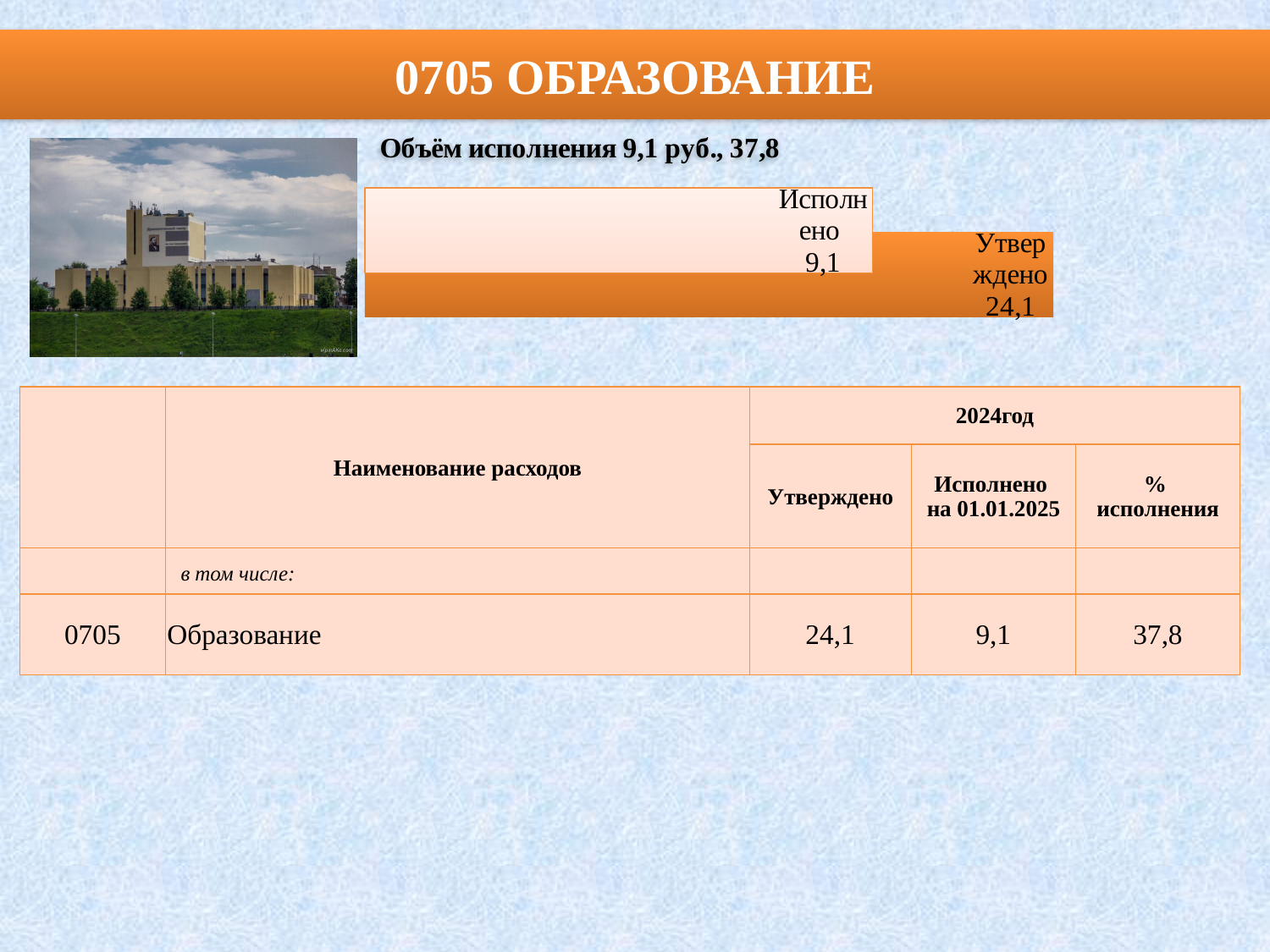
What is the difference between the "Утверждено" value and the "Исполнено" value? 15,0 What is the value of the bar labelled "Утверждено"? 24,1 What is the title shown in the orange banner at the top of the slide? 0705 ОБРАЗОВАНИЕ What is the value of the bar labelled "Исполнено"? 9,1 What colour is the bar labelled "Утверждено"? orange Which bar has the highest value? Утверждено What kind of chart is shown on the slide? bar chart Which is larger, the value for "Утверждено" or the value for "Исполнено"? Утверждено How many bars does the chart show? 2 Which bar has the lowest value? Исполнено